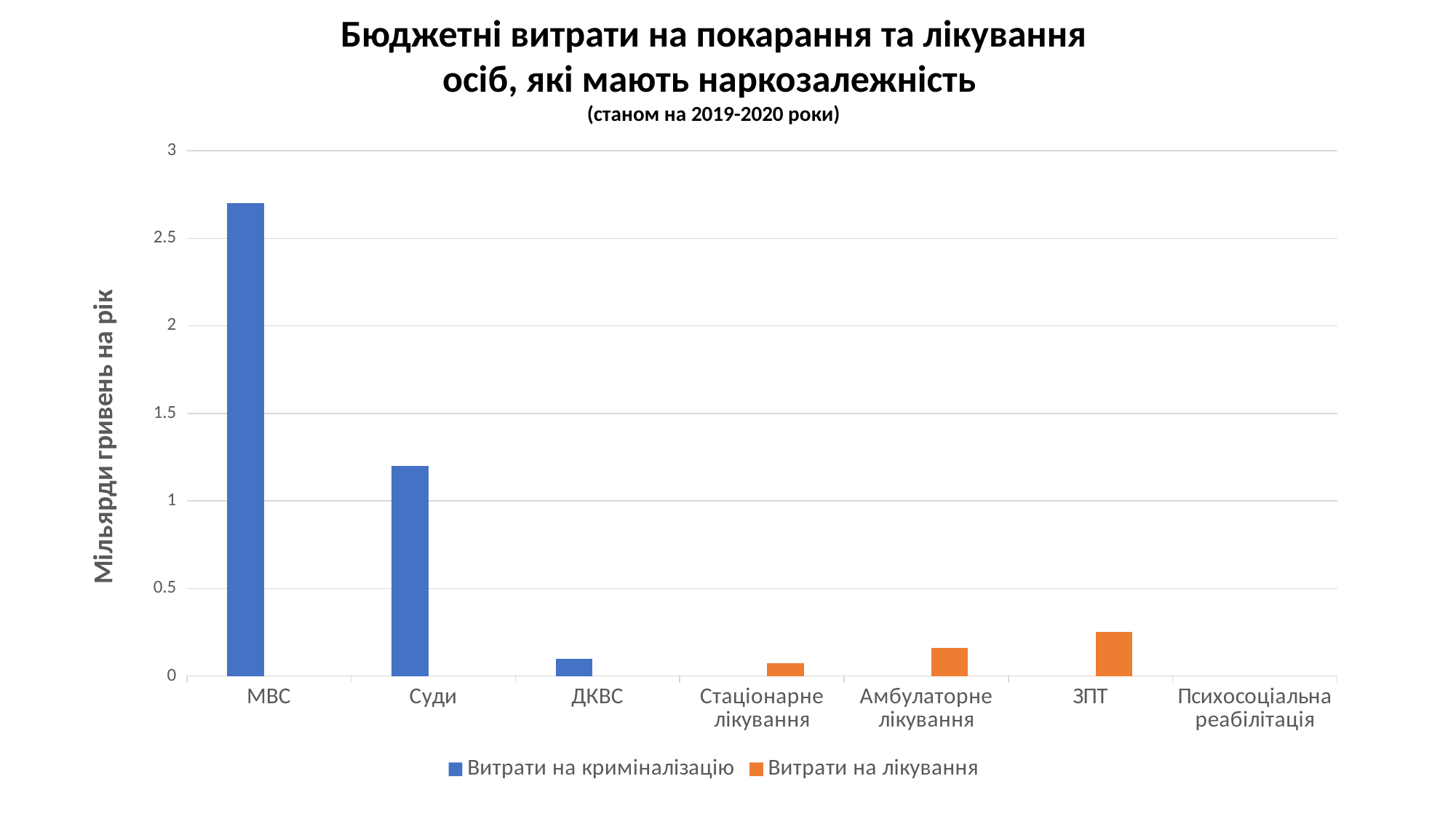
Which is larger, the value for МВС or the value for Суди? МВС How many categories are shown on the x axis? 7 How many series does the legend list? 2 Is the value for МВС greater or less than 2.5? greater What is the label of the y axis? Мільярди гривень на рік Is the value for Суди greater or less than 1? greater Which category has the highest value? МВС Is the value for ЗПТ greater or less than 0.5? less Which is larger, the value for Амбулаторне лікування or the value for Стаціонарне лікування? Амбулаторне лікування What kind of chart is shown on the slide? Bar chart Which series is shown in orange according to the legend? Витрати на лікування